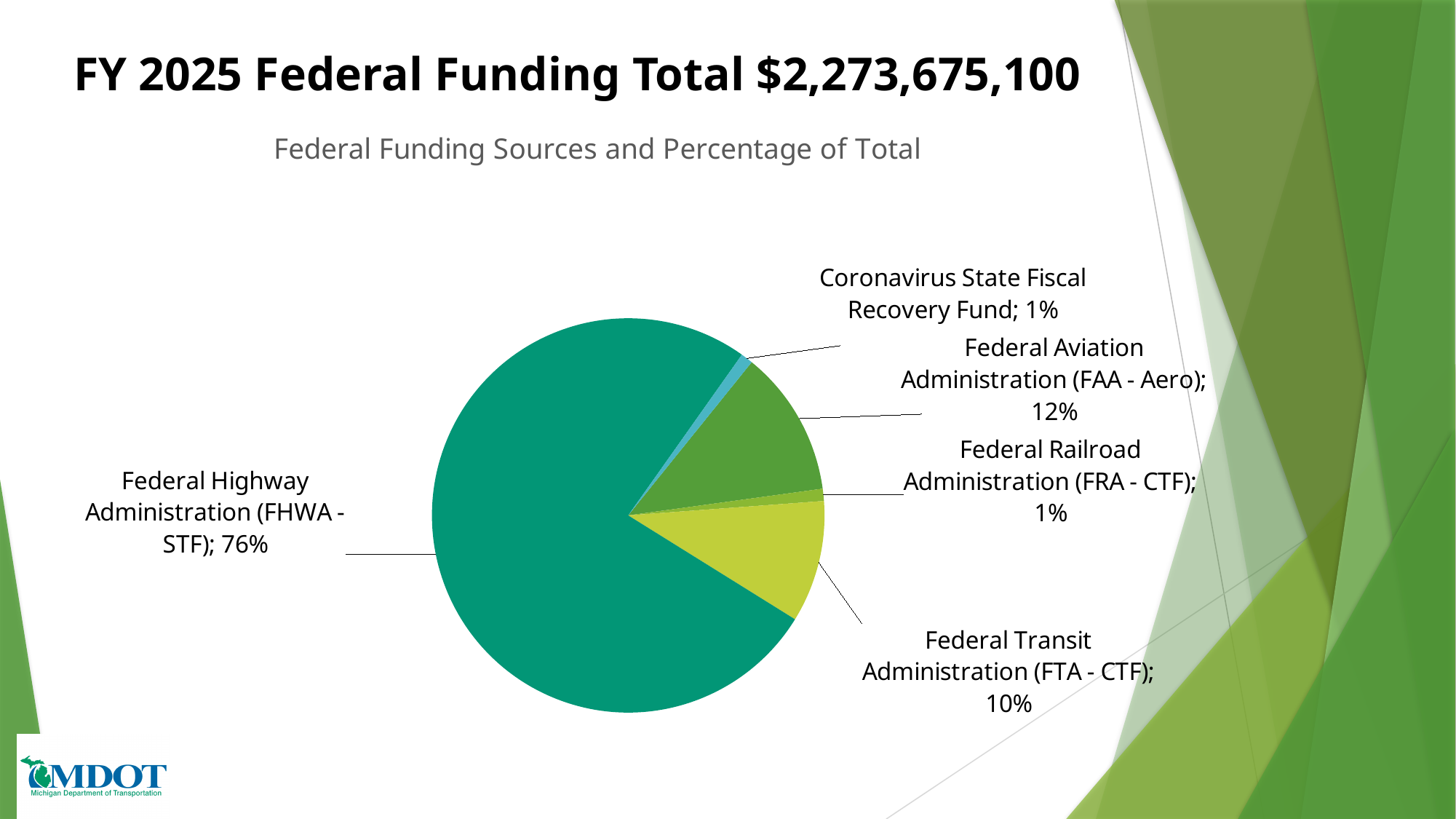
What percentage of the total is Federal Highway Administration (FHWA - STF)? 76% What percentage of the total is Federal Railroad Administration (FRA - CTF)? 1% Which is larger, the share for Federal Aviation Administration (FAA - Aero) or Federal Transit Administration (FTA - CTF)? Federal Aviation Administration (FAA - Aero) How many slices does the pie chart have? 5 What kind of chart is shown on the slide? Pie chart What percentage of the total is Federal Transit Administration (FTA - CTF)? 10% What is the difference in percentage points between the Federal Highway Administration (FHWA - STF) share and the Federal Aviation Administration (FAA - Aero) share? 64 percentage points Which funding source has the largest share of the pie? Federal Highway Administration (FHWA - STF) What percentage of the total is the Coronavirus State Fiscal Recovery Fund? 1% What percentage of the total is Federal Aviation Administration (FAA - Aero)? 12% What is the chart's title? Federal Funding Sources and Percentage of Total What is the FY 2025 federal funding total stated in the slide heading? $2,273,675,100